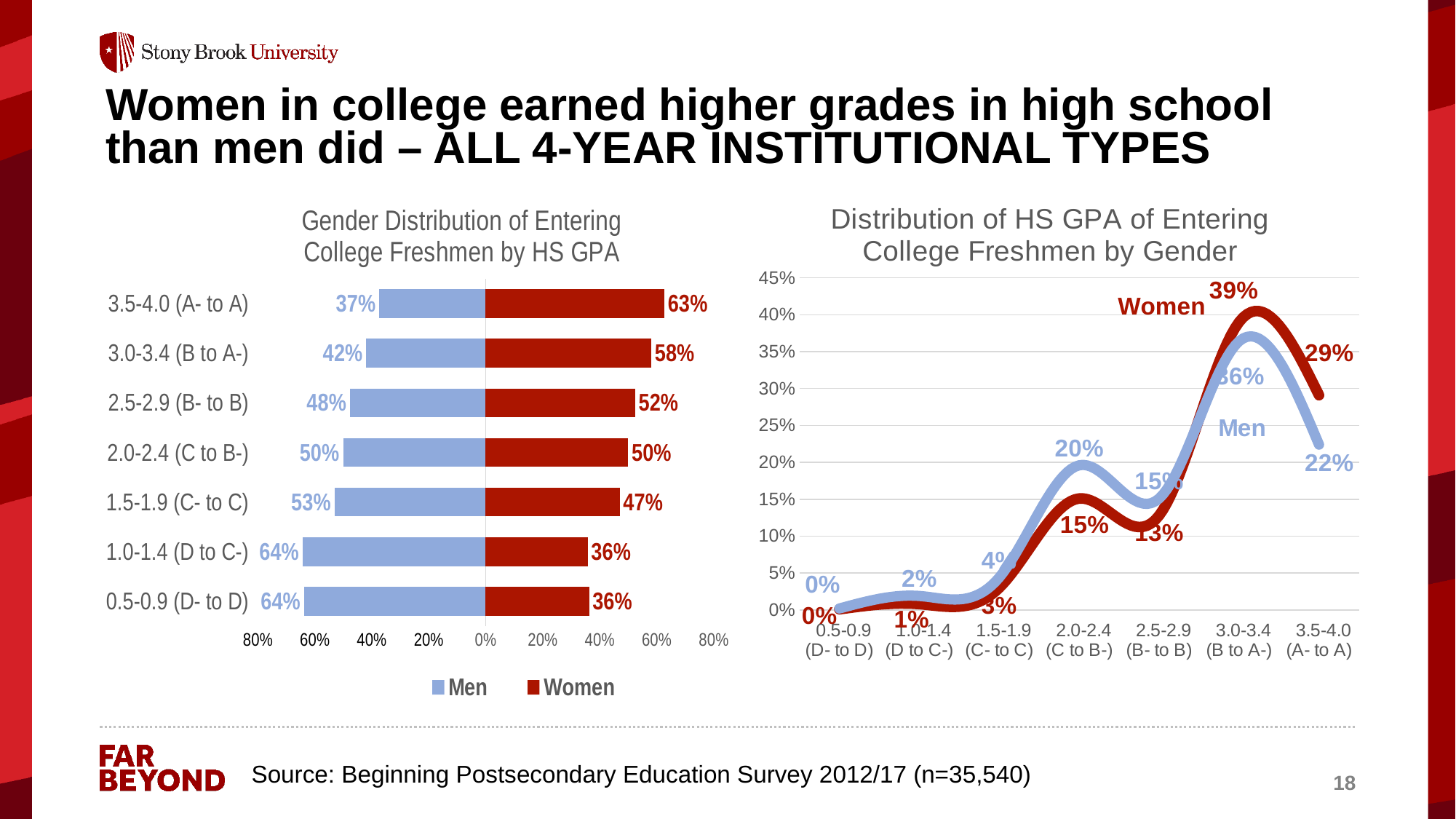
What type of chart is the 'Gender Distribution of Entering College Freshmen by HS GPA' chart? Bar chart In the 'Distribution of HS GPA of Entering College Freshmen by Gender' chart, which is larger for 3.5-4.0 (A- to A): Men or Women? Women In the 'Gender Distribution of Entering College Freshmen by HS GPA' chart, what percentage of the 3.0-3.4 (B to A-) group is Men? 42% In the 'Distribution of HS GPA of Entering College Freshmen by Gender' chart, what is the difference between the Women and Men values for 3.5-4.0 (A- to A)? 7% In the 'Gender Distribution of Entering College Freshmen by HS GPA' chart, which GPA category has the lowest Men percentage? 3.5-4.0 (A- to A) What type of chart is the 'Distribution of HS GPA of Entering College Freshmen by Gender' chart? Line chart In the 'Distribution of HS GPA of Entering College Freshmen by Gender' chart, what is the Men value for 2.0-2.4 (C to B-)? 20% In the 'Gender Distribution of Entering College Freshmen by HS GPA' chart, how many GPA categories are shown? 7 In the 'Gender Distribution of Entering College Freshmen by HS GPA' chart, what is the difference between the Women and Men percentages for the 1.0-1.4 (D to C-) group? 28% In the 'Gender Distribution of Entering College Freshmen by HS GPA' chart, how many series does the legend list? 2 In the 'Gender Distribution of Entering College Freshmen by HS GPA' chart, what percentage of the 3.5-4.0 (A- to A) group is Women? 63% In the 'Distribution of HS GPA of Entering College Freshmen by Gender' chart, what is the Women value for 3.0-3.4 (B to A-)? 39%